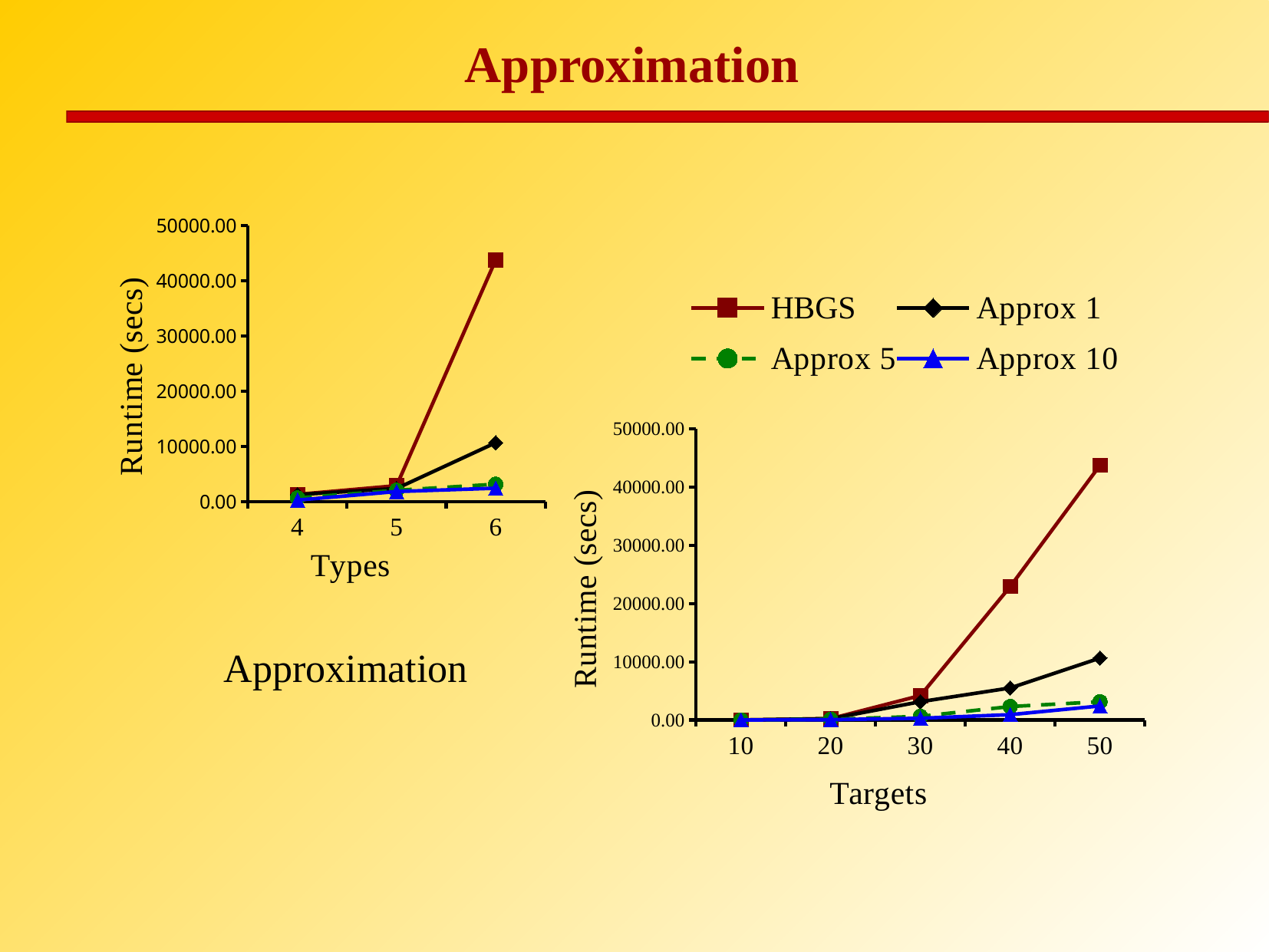
What is the y-axis label of the chart with the x axis labelled Targets? Runtime (secs) In the chart with the x axis labelled Targets, how many x-axis points are plotted? 5 How many series does the legend list? 4 In the chart with the x axis labelled Types, how many x-axis points are plotted? 3 In the chart with the x axis labelled Targets, does the HBGS runtime rise or fall as the number of targets increases? rise In the chart with the x axis labelled Targets, which is larger at 50 targets: the HBGS runtime or the Approx 1 runtime? HBGS What kind of chart is the chart with the x axis labelled Types? line chart In the chart with the x axis labelled Targets, is the Approx 1 runtime at 40 targets greater or less than 10000.00? less Which series is drawn with a dashed green line and circle markers? Approx 5 In the chart with the x axis labelled Types, which series has the highest runtime at 6 types? HBGS In the chart with the x axis labelled Types, is the HBGS runtime at 6 types greater or less than 40000.00? greater In the chart with the x axis labelled Targets, is the HBGS runtime at 40 targets greater or less than 20000.00? greater